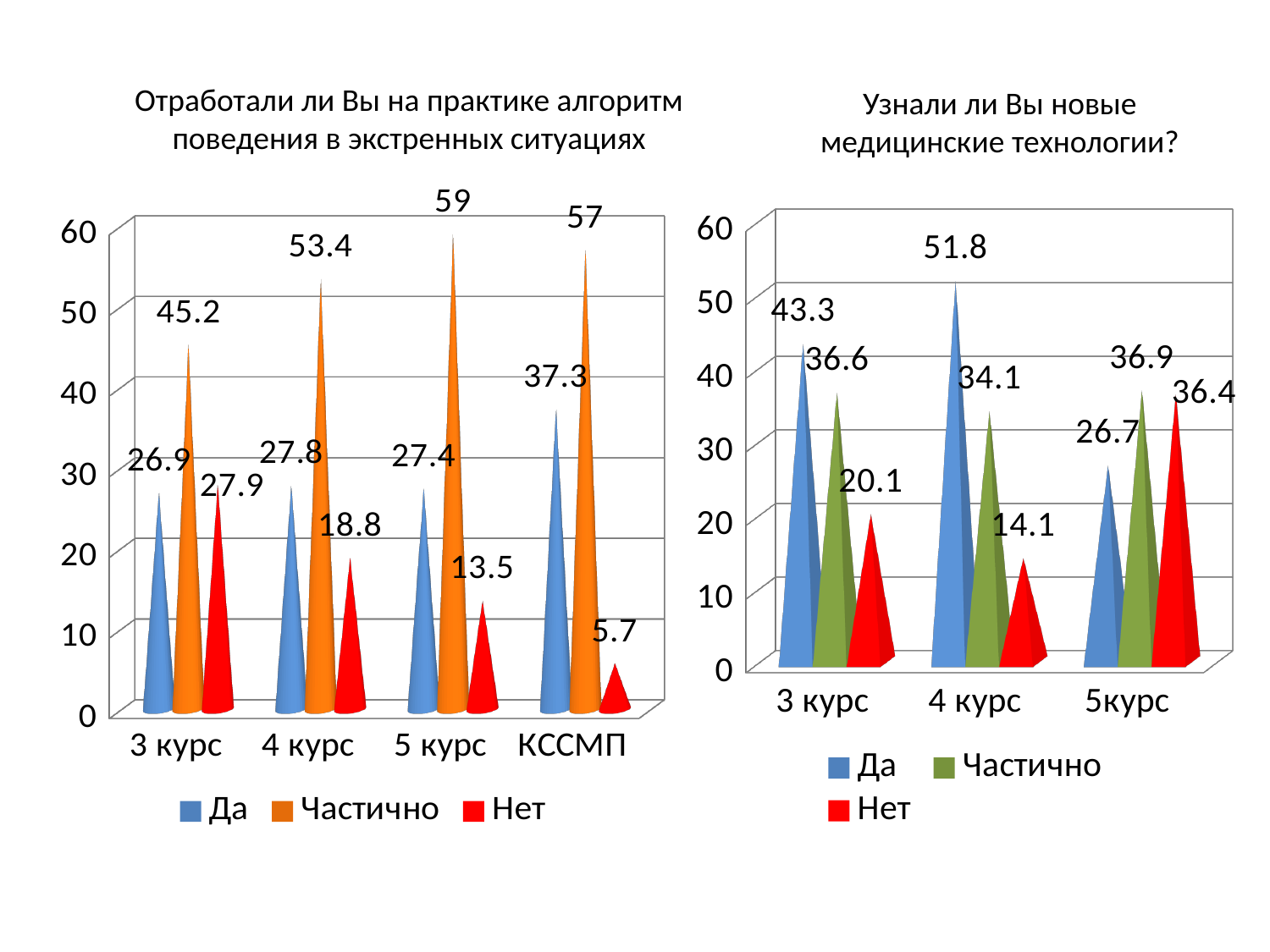
In the right chart (Узнали ли Вы новые медицинские технологии?), what is the value for Да for 4 курс? 51.8 In the right chart, what is the value for Нет for 3 курс? 20.1 In the left chart (Отработали ли Вы на практике алгоритм поведения в экстренных ситуациях), what is the value for Частично for 5 курс? 59 In the right chart, which is larger for 5курс: Да or Частично? Частично In the left chart, what is the value for Нет for КССМП? 5.7 What kind of chart is the right chart? Bar chart In the left chart, how many categories are shown on the x axis? 4 In the left chart, what is the difference between Частично and Да for 4 курс? 25.6 In the left chart, which category has the lowest value for Нет? КССМП In the right chart, which category has the highest value for Нет? 5курс In the right chart, how many series does the legend list? 3 In the left chart, which category has the highest value for Да? КССМП